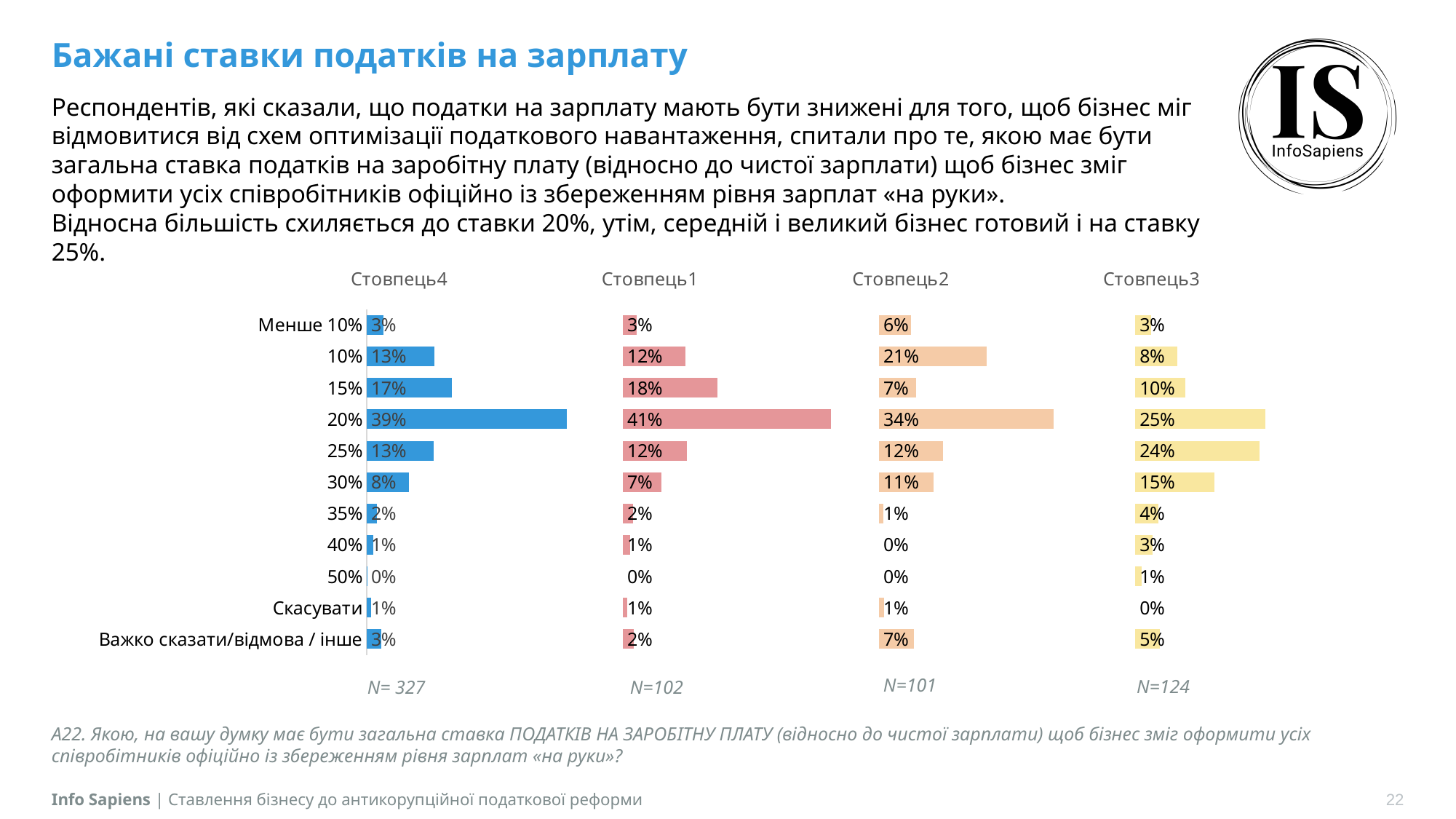
In the chart titled Стовпець2, what is the value for 10%? 21% In the chart titled Стовпець1, what is the difference between the values for 20% and 15%? 23% What type of chart is the chart titled Стовпець1? Bar chart In the chart titled Стовпець3, which category has the highest value? 20% In the chart titled Стовпець4, what is the value for 20%? 39% In the chart titled Стовпець3, what is the difference between the values for 30% and 10%? 7% What is the sample size (N) shown under the chart titled Стовпець4? N= 327 How many categories are shown in the chart titled Стовпець4? 11 In the chart titled Стовпець2, which is larger: the value for 10% or the value for 25%? 10% In the chart titled Стовпець2, which category has the highest value? 20% In the chart titled Стовпець3, what is the value for 25%? 24% In the chart titled Стовпець1, what is the value for 15%? 18%